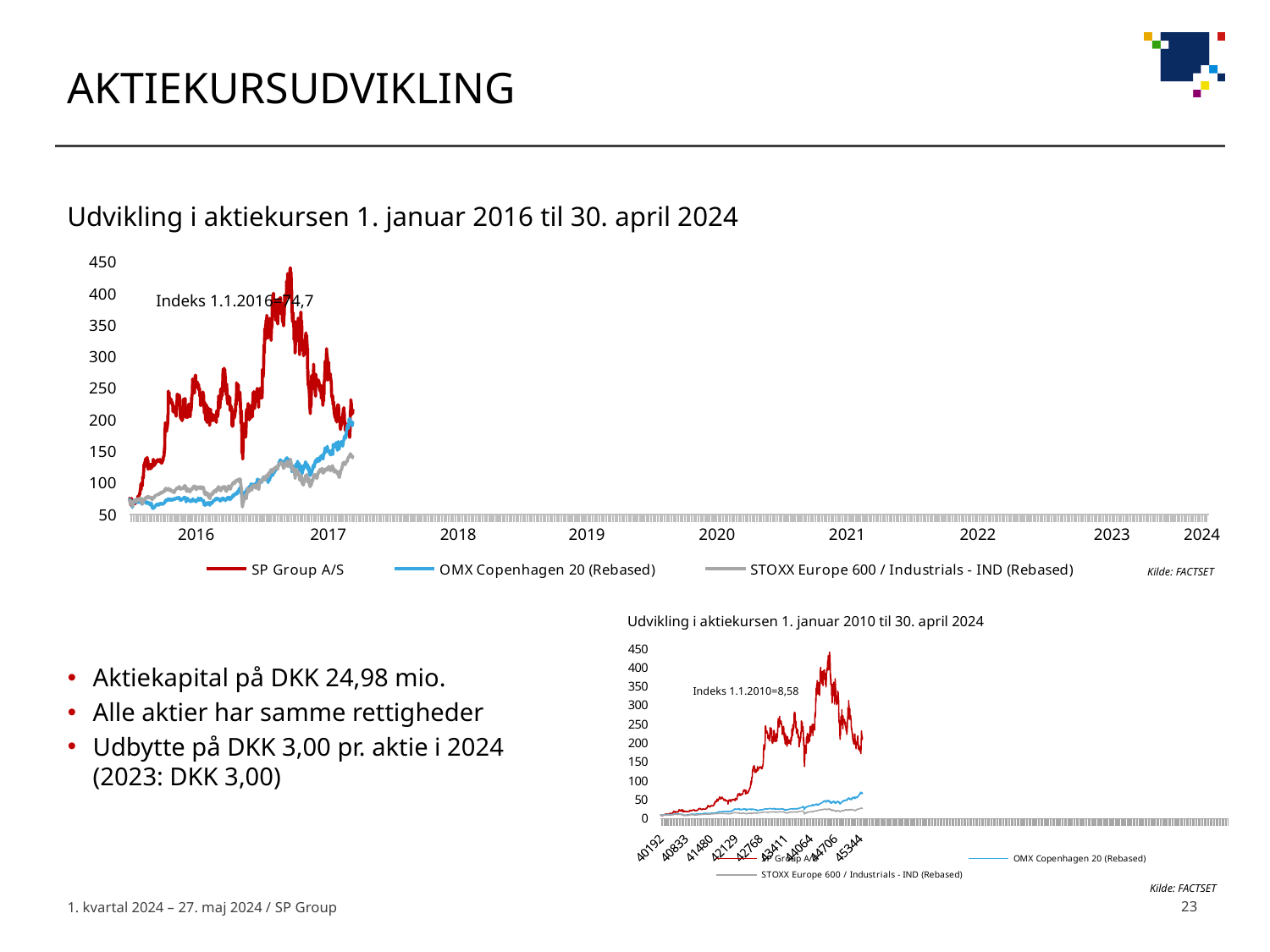
What is the title of the bottom chart? Udvikling i aktiekursen 1. januar 2010 til 30. april 2024 In the top chart, which series reaches the highest value? SP Group A/S In the bottom chart, is the peak value of SP Group A/S greater or less than 400? greater What kind of chart is the top chart titled 'Udvikling i aktiekursen 1. januar 2016 til 30. april 2024'? Line chart In the top chart, is the peak value of SP Group A/S greater or less than 400? greater In the top chart, which series is higher at its peak: SP Group A/S or STOXX Europe 600 / Industrials - IND (Rebased)? SP Group A/S In the bottom chart, is the highest value of OMX Copenhagen 20 (Rebased) greater or less than 100? less How many series does the legend of the bottom chart list? 3 How many series does the legend of the top chart list? 3 What index base value is noted on the top chart? Indeks 1.1.2016=74,7 In the bottom chart, which series reaches the highest value? SP Group A/S